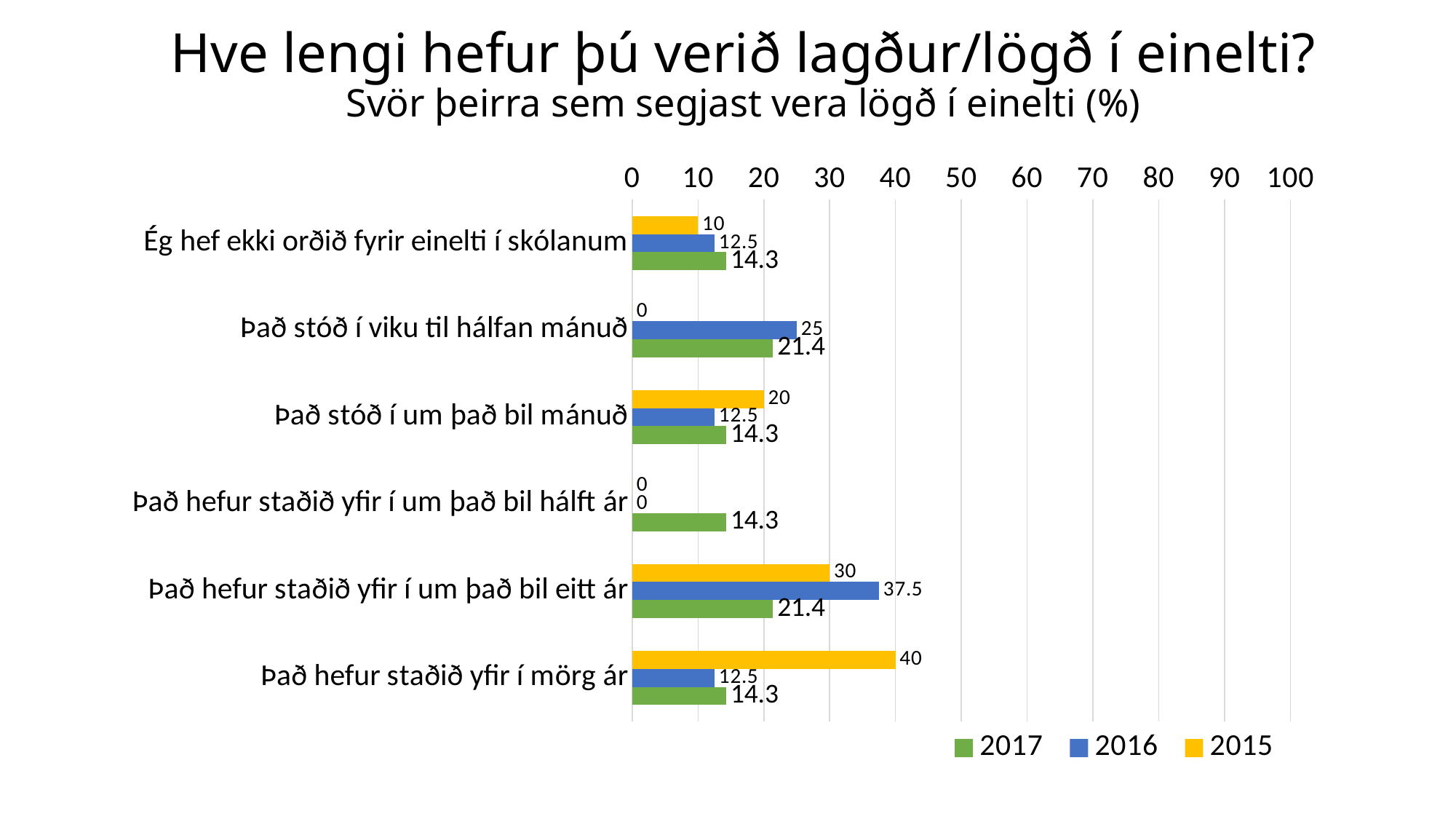
Which category has the highest 2015 value? Það hefur staðið yfir í mörg ár How many series does the legend list? 3 Which colour represents the 2015 series in the legend? Yellow Which category has the highest 2016 value? Það hefur staðið yfir í um það bil eitt ár What is the difference between the 2015 and 2016 values for "Það hefur staðið yfir í mörg ár"? 27.5 What is the 2017 value for "Það stóð í viku til hálfan mánuð"? 21.4 For "Það stóð í um það bil mánuð", which is larger: the 2015 value or the 2017 value? 2015 What is the 2016 value for "Það hefur staðið yfir í um það bil eitt ár"? 37.5 Is the 2016 value for "Það hefur staðið yfir í um það bil eitt ár" greater or less than 30? greater What type of chart is shown on the slide? Bar chart What is the 2015 value for "Það hefur staðið yfir í mörg ár"? 40 How many categories are shown on the chart? 6